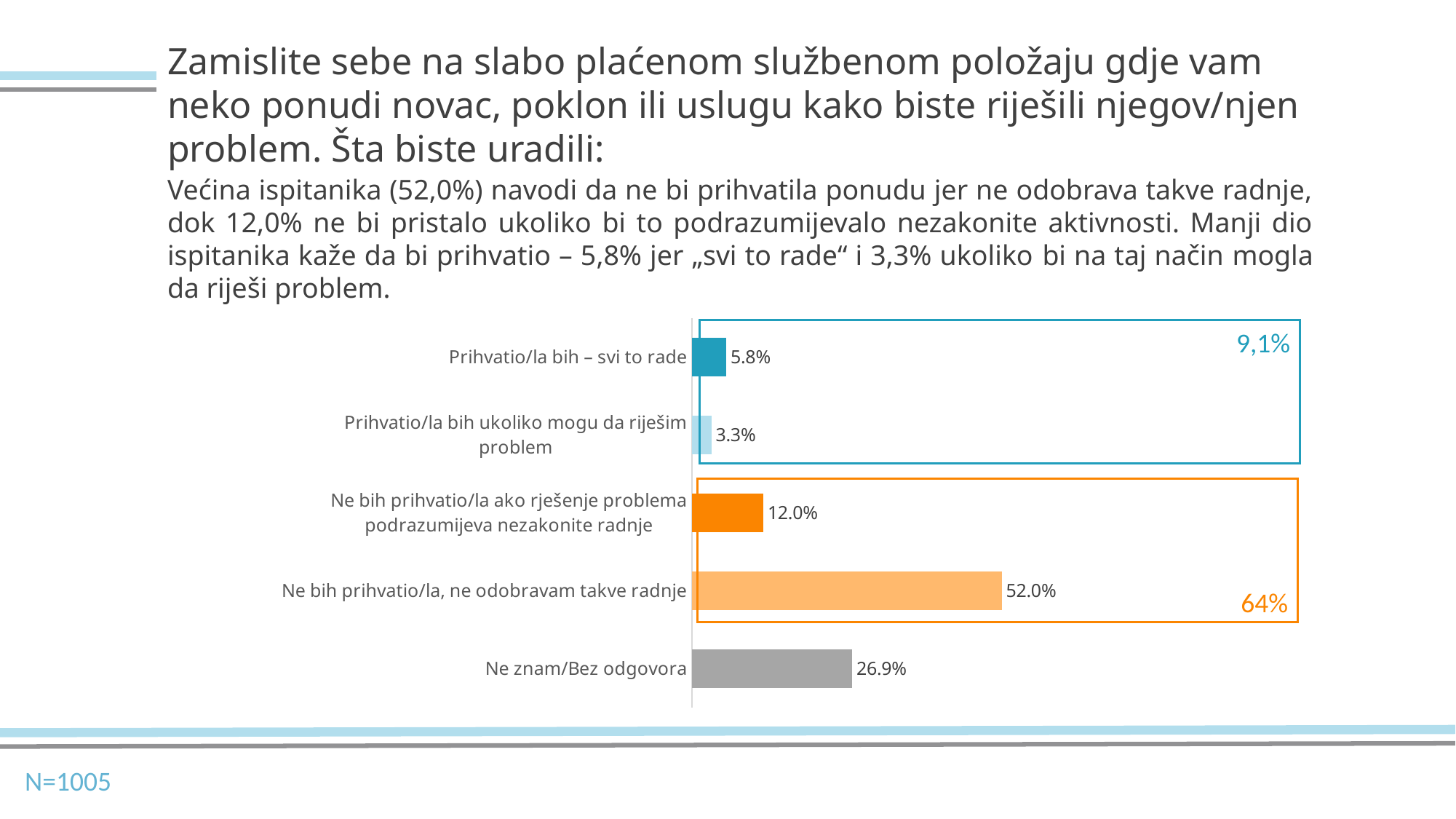
Which category has the lowest value? Prihvatio/la bih ukoliko mogu da riješim problem Which is larger: "Prihvatio/la bih – svi to rade" or "Prihvatio/la bih ukoliko mogu da riješim problem"? Prihvatio/la bih – svi to rade What is the difference between "Ne bih prihvatio/la, ne odobravam takve radnje" and "Ne znam/Bez odgovora"? 25.1% Which category has the highest value? Ne bih prihvatio/la, ne odobravam takve radnje What kind of chart is shown on the slide? Bar chart What combined percentage is shown in the orange box grouping the two "Ne bih prihvatio/la" categories? 64% What combined percentage is shown in the blue box grouping the two "Prihvatio/la bih" categories? 9,1% How many categories are shown in the chart? 5 What is the value for "Ne znam/Bez odgovora"? 26.9% What is the value for "Prihvatio/la bih – svi to rade"? 5.8% What is the value for "Ne bih prihvatio/la ako rješenje problema podrazumijeva nezakonite radnje"? 12.0% What is the value for "Ne bih prihvatio/la, ne odobravam takve radnje"? 52.0%